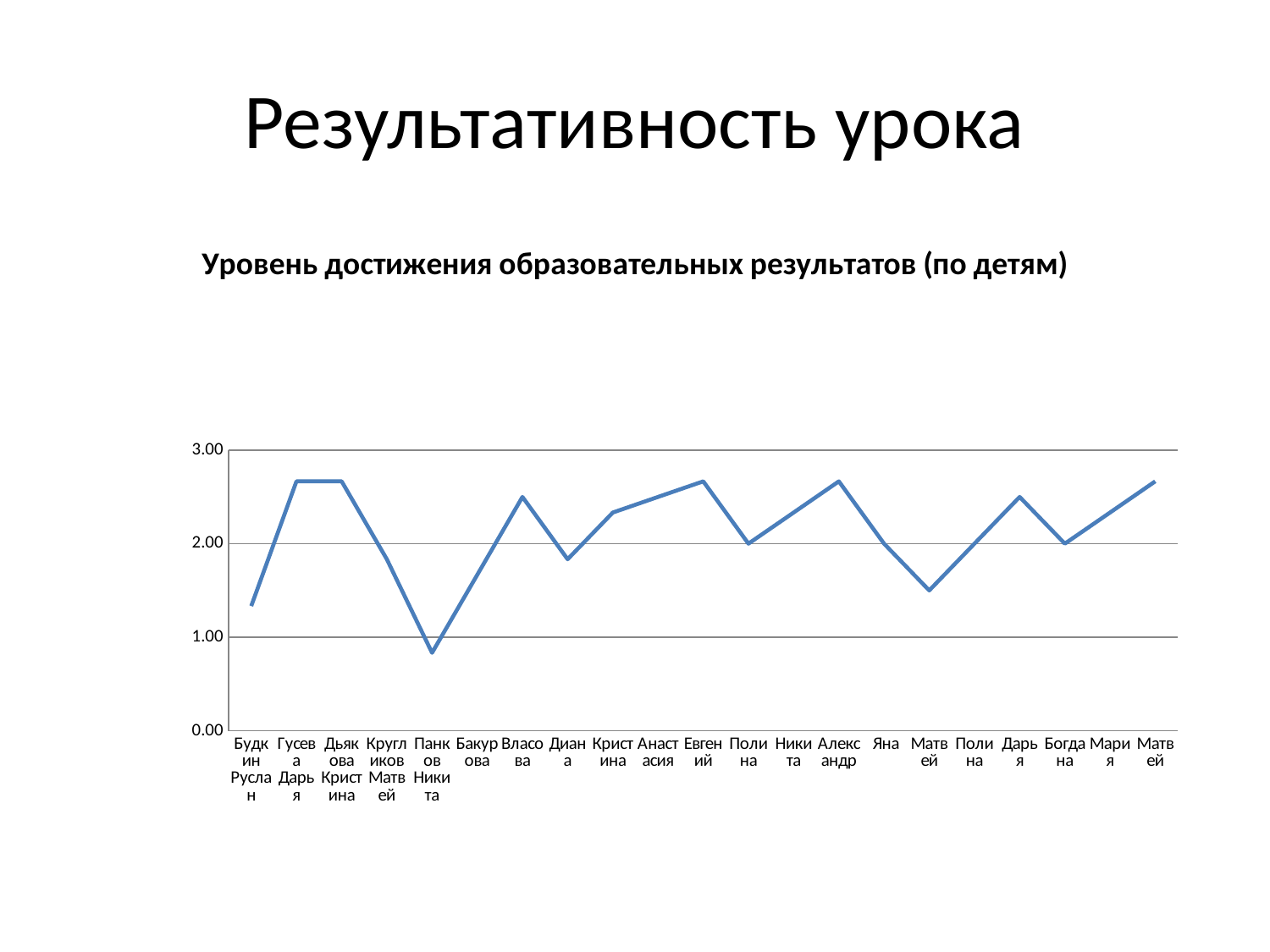
What kind of chart is shown on the slide? line chart Is the value for Евгений greater or less than 2.00? greater Which child has the lowest value on the chart? Панков Никита Is the value for Панков Никита greater or less than 1.00? less Is the value for Гусева Дарья greater or less than 2.00? greater Which is larger, the value for Будкин Руслан or the value for Дьякова Кристина? Дьякова Кристина What is the title of the chart? Уровень достижения образовательных результатов (по детям) How many children (categories) are plotted along the x axis? 21 Which is larger, the value for Гусева Дарья or the value for Панков Никита? Гусева Дарья